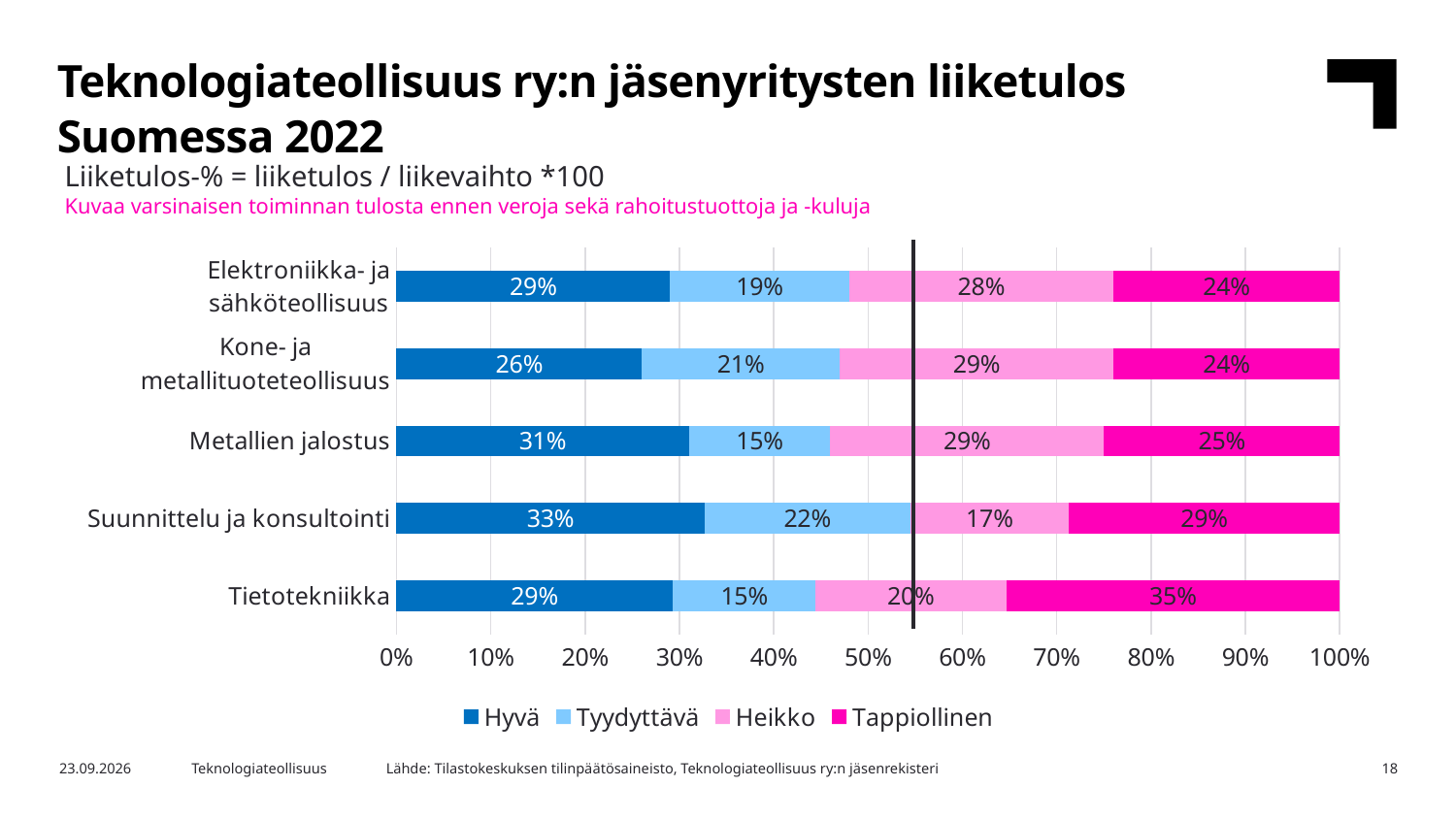
What is the combined share of Hyvä and Tyydyttävä for Suunnittelu ja konsultointi? 55% What is the Tyydyttävä share for Kone- ja metallituoteteollisuus? 21% How many series does the legend list? 4 What is the Hyvä share for Suunnittelu ja konsultointi? 33% What is the difference between the Tappiollinen share of Tietotekniikka and that of Metallien jalostus? 10 percentage points Which category has the highest Tappiollinen share? Tietotekniikka What kind of chart is shown on the slide? Stacked bar chart Which category has the lowest Hyvä share? Kone- ja metallituoteteollisuus Which is larger: the Heikko share for Metallien jalostus or the Heikko share for Suunnittelu ja konsultointi? Metallien jalostus What is the Heikko share for Elektroniikka- ja sähköteollisuus? 28% How many industry categories are shown in the chart? 5 What is the Tappiollinen share for Tietotekniikka? 35%